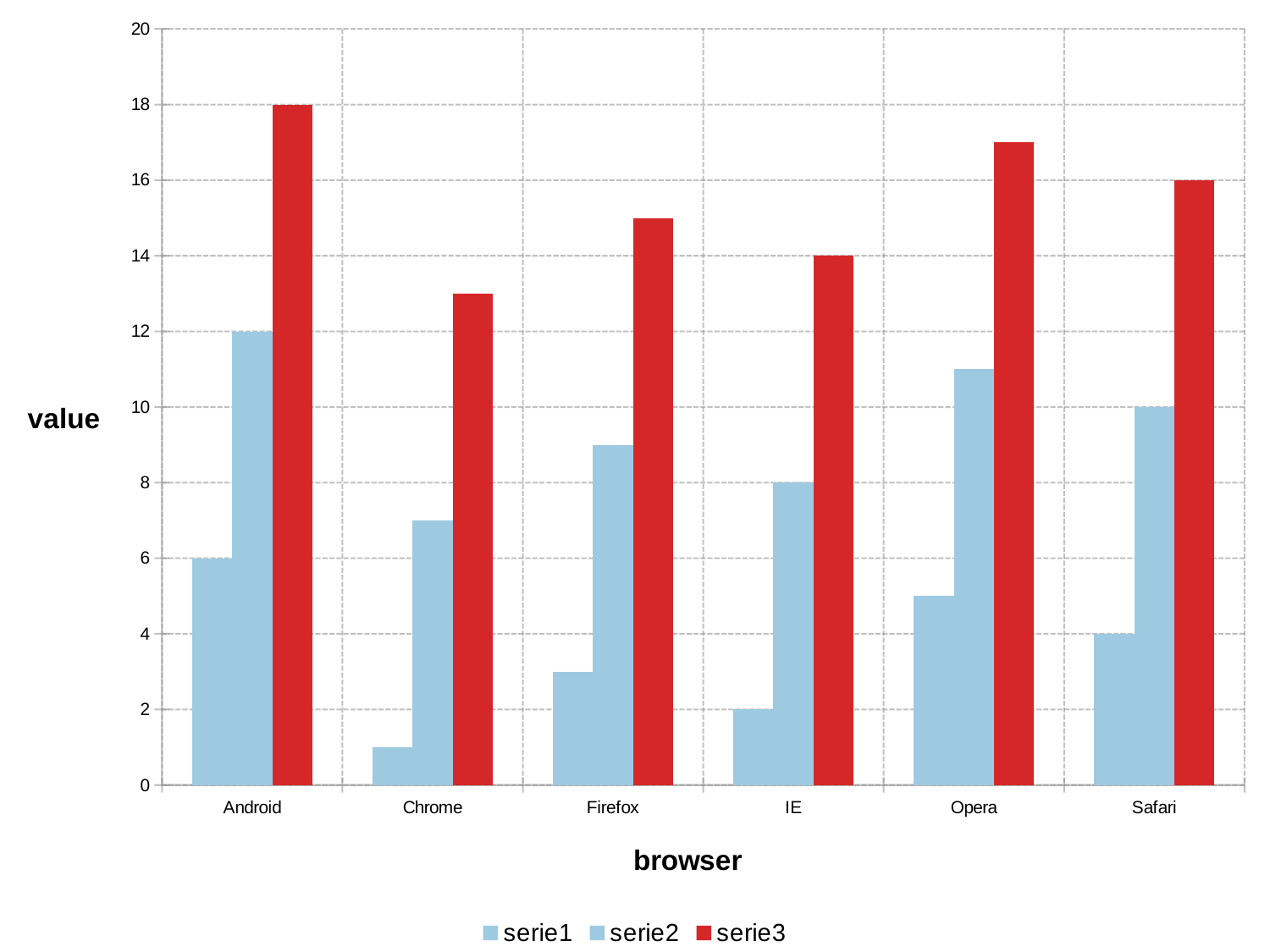
Which is larger, the serie3 value for Opera or for Safari? Opera How many browsers are shown on the x axis? 6 In the Android group, what is the value of the taller light blue bar? 12 What is the value of serie3 for Android? 18 Is the serie3 value for Chrome greater or less than 12? greater Which browser has the lowest serie3 value? Chrome What kind of chart is shown on the slide? bar chart What is the value of serie3 for Safari? 16 What is the difference between the serie3 values for Android and IE? 4 How many series does the legend list? 3 What is the value of serie3 for IE? 14 Which browser has the highest serie3 value? Android